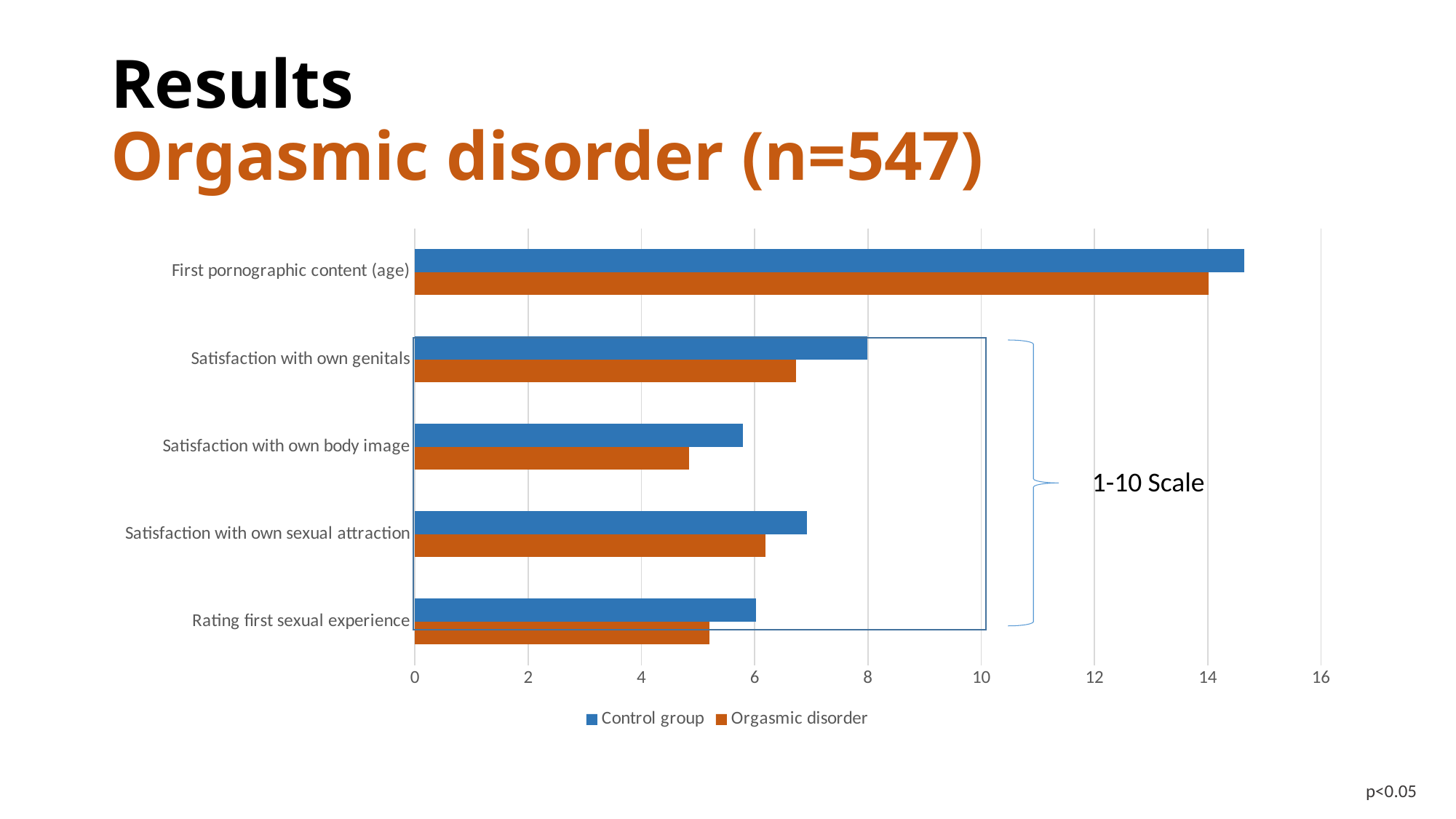
Is the Orgasmic disorder value for Satisfaction with own body image greater or less than 6? less What scale does the annotation beside the bracket say applies to the satisfaction and rating categories? 1-10 Scale How many categories are plotted on the chart? 5 Which category has the highest value for the Control group? First pornographic content (age) How many series does the chart's legend list? 2 Which category has the highest value for the Orgasmic disorder group? First pornographic content (age) For Satisfaction with own sexual attraction, which group has the larger value, Control group or Orgasmic disorder? Control group Is the Control group value for First pornographic content (age) greater or less than 14? greater What are the two series named in the legend? Control group and Orgasmic disorder What kind of chart is shown on the slide? bar chart